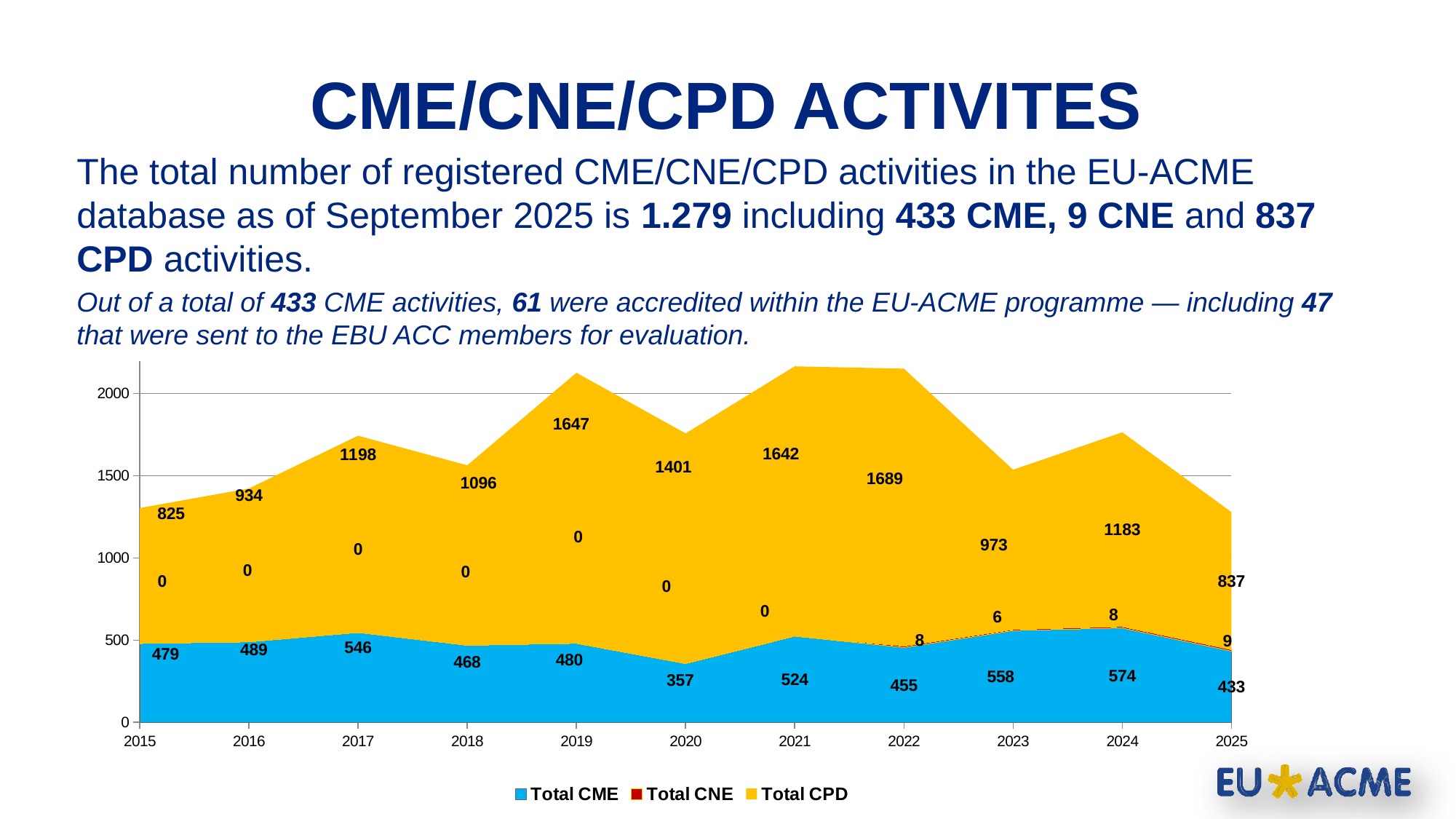
What is the total of all three series for 2025? 1279 In which year is Total CPD highest? 2022 What is the Total CPD value for 2019? 1647 Which is larger, Total CPD in 2017 or Total CPD in 2018? Total CPD in 2017 How many years are plotted along the x axis? 11 What is the difference between Total CME in 2024 and Total CME in 2025? 141 What kind of chart is shown on the slide? Stacked area chart How many series does the legend list? 3 Which series is shown in yellow? Total CPD What is the Total CNE value for 2023? 6 What is the Total CME value for 2020? 357 In which year is Total CME lowest? 2020